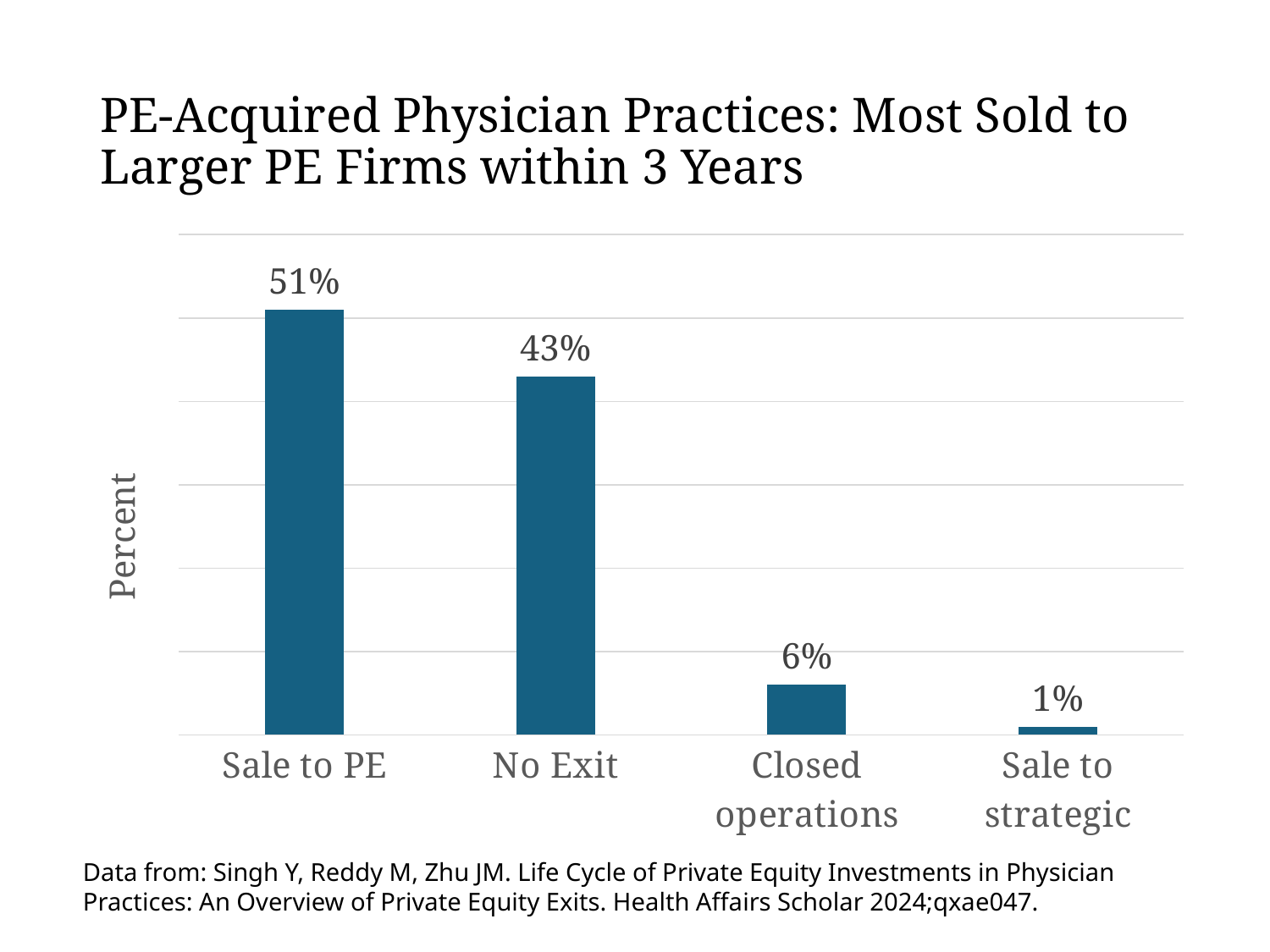
Which category has the lowest value? Sale to strategic What is the value for Sale to strategic? 1% Which category has the highest value? Sale to PE How many categories are shown on the x axis? 4 What is the difference between the values for Sale to PE and No Exit? 8% What kind of chart is shown on the slide? Bar chart What is the label on the vertical axis? Percent What is the value for Sale to PE? 51% Which is larger, the value for No Exit or the value for Closed operations? No Exit What is the difference between the values for Closed operations and Sale to strategic? 5% What is the value for Closed operations? 6% What is the value for No Exit? 43%